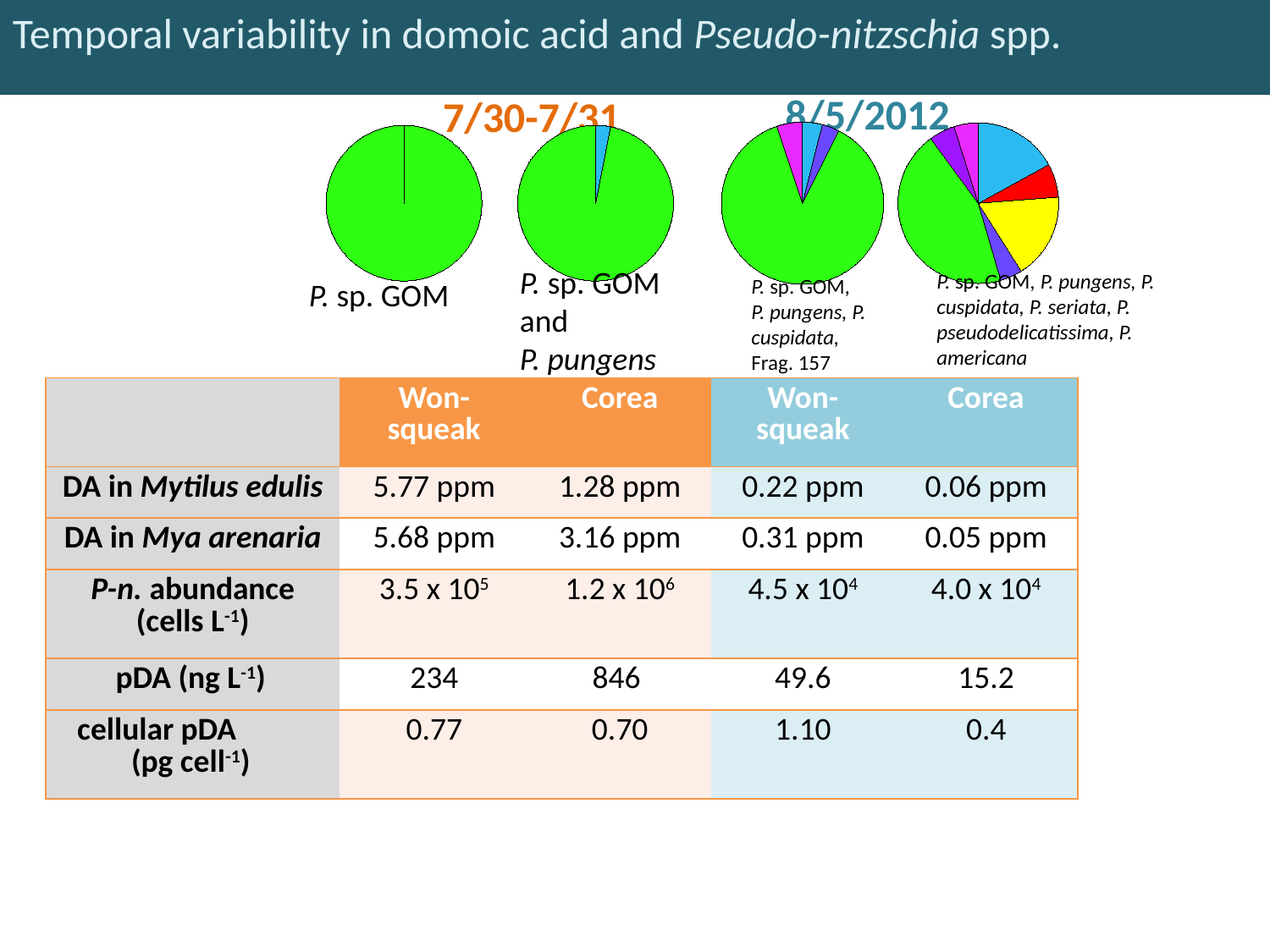
Which pie chart has the most slices? The rightmost pie (8/5/2012, P. sp. GOM, P. pungens, P. cuspidata, P. seriata, P. pseudodelicatissima, P. americana) Which two date labels are shown above the pie charts? 7/30-7/31 and 8/5/2012 Which colour represents the largest slice in every pie chart on the slide? Green How many pie charts are on the slide? 4 In the second pie chart from the left (P. sp. GOM and P. pungens), which slice is larger, the green one or the blue one? Green In the rightmost pie chart, which slice is larger, the yellow one or the red one? Yellow What kind of charts are shown at the top of the slide? Pie charts How many species are listed in the label under the rightmost pie chart? 6 In the rightmost pie chart, which slice is larger, the light blue one or the red one? Light blue